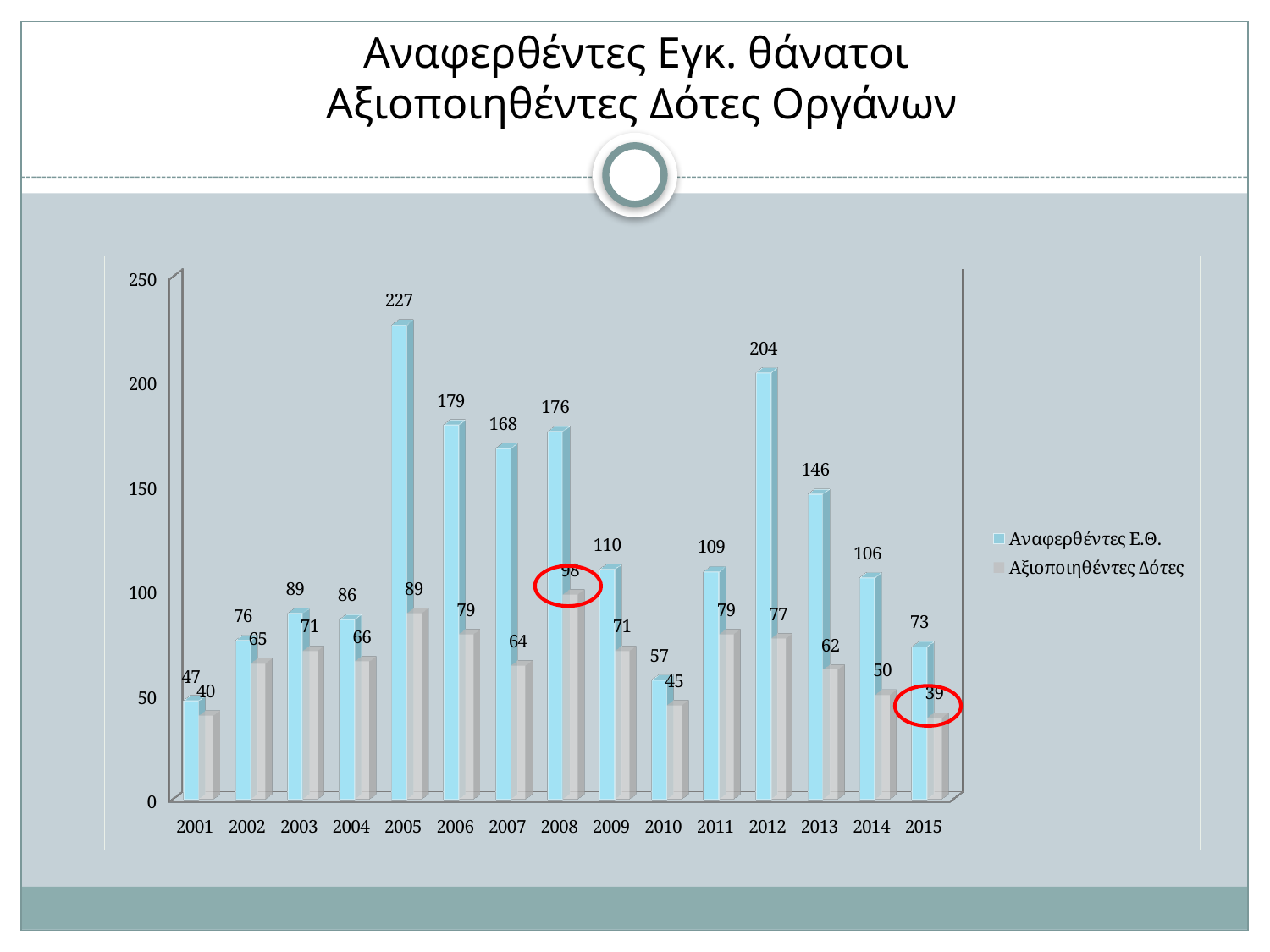
What kind of chart is shown on the slide? Bar chart Which series is shown in blue in the legend? Αναφερθέντες Ε.Θ. What is the value for Αξιοποιηθέντες Δότες in 2015? 39 In which year is the Αξιοποιηθέντες Δότες value lowest? 2015 Is the value for Αναφερθέντες Ε.Θ. in 2013 greater or less than 100? greater What is the value for Αξιοποιηθέντες Δότες in 2008? 98 How many years are shown on the x axis? 15 Which is larger: Αναφερθέντες Ε.Θ. in 2006 or Αναφερθέντες Ε.Θ. in 2008? 2006 What is the difference between Αναφερθέντες Ε.Θ. and Αξιοποιηθέντες Δότες in 2012? 127 In which year is the Αναφερθέντες Ε.Θ. value highest? 2005 What is the value for Αναφερθέντες Ε.Θ. in 2005? 227 How many series does the legend list? 2